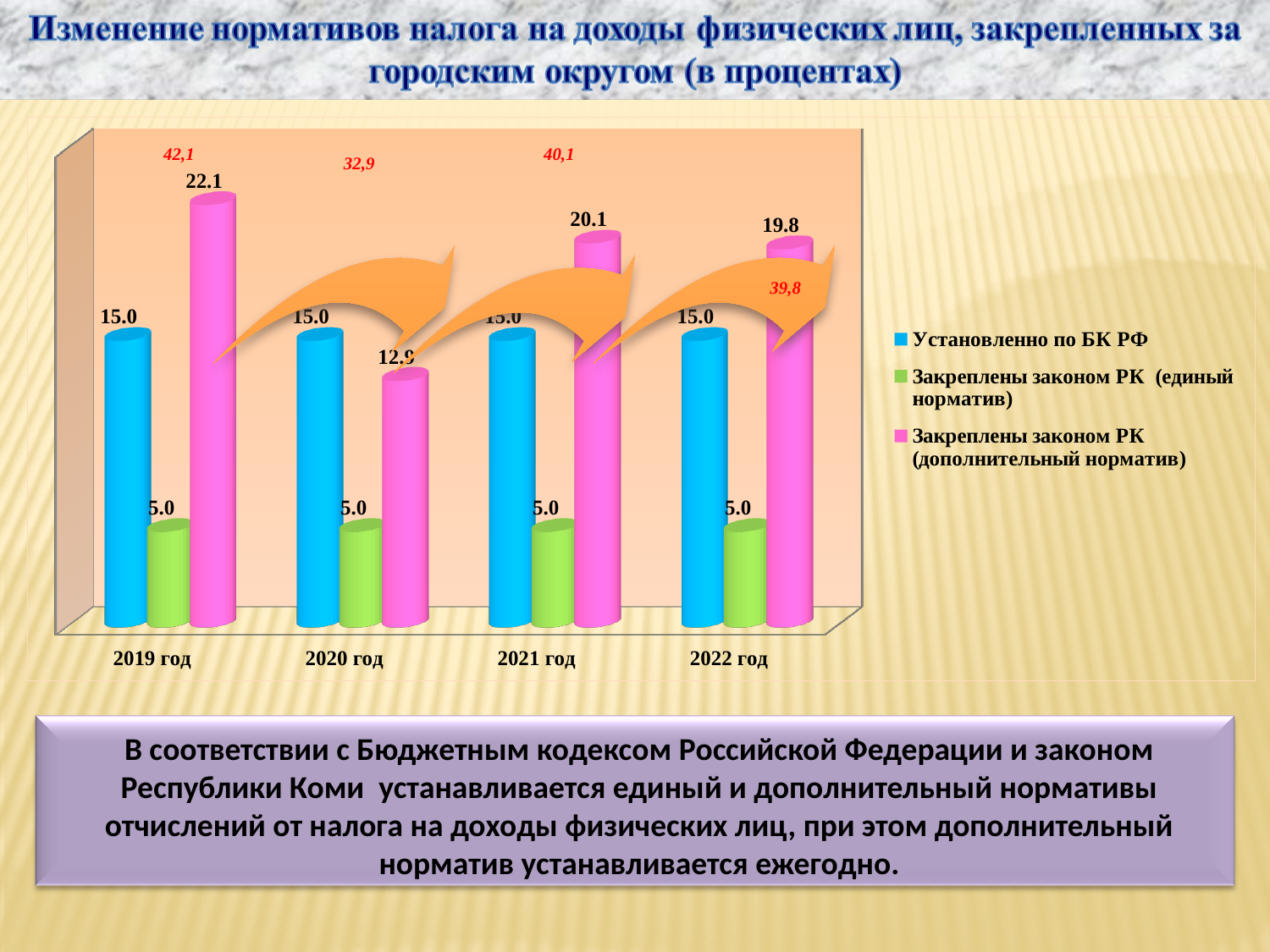
How many year categories are shown on the x axis of the chart? 4 Which is larger for 2022 год: the 'Установленно по БК РФ' value or the 'Закреплены законом РК (дополнительный норматив)' value? Закреплены законом РК (дополнительный норматив) What type of chart is shown on the slide? bar chart What is the value of the 'Установленно по БК РФ' series for 2020 год? 15.0 In which year is the 'Закреплены законом РК (дополнительный норматив)' value the highest? 2019 год How many series does the chart legend list? 3 What is the value of the 'Закреплены законом РК (дополнительный норматив)' series for 2019 год? 22.1 In which year is the 'Закреплены законом РК (дополнительный норматив)' value the lowest? 2020 год What is the value of the 'Закреплены законом РК (дополнительный норматив)' series for 2022 год? 19.8 What is the difference between the 'Закреплены законом РК (дополнительный норматив)' values for 2019 год and 2021 год? 2.0 What is the value of the 'Закреплены законом РК (единый норматив)' series for 2022 год? 5.0 What is the value of the 'Закреплены законом РК (дополнительный норматив)' series for 2021 год? 20.1